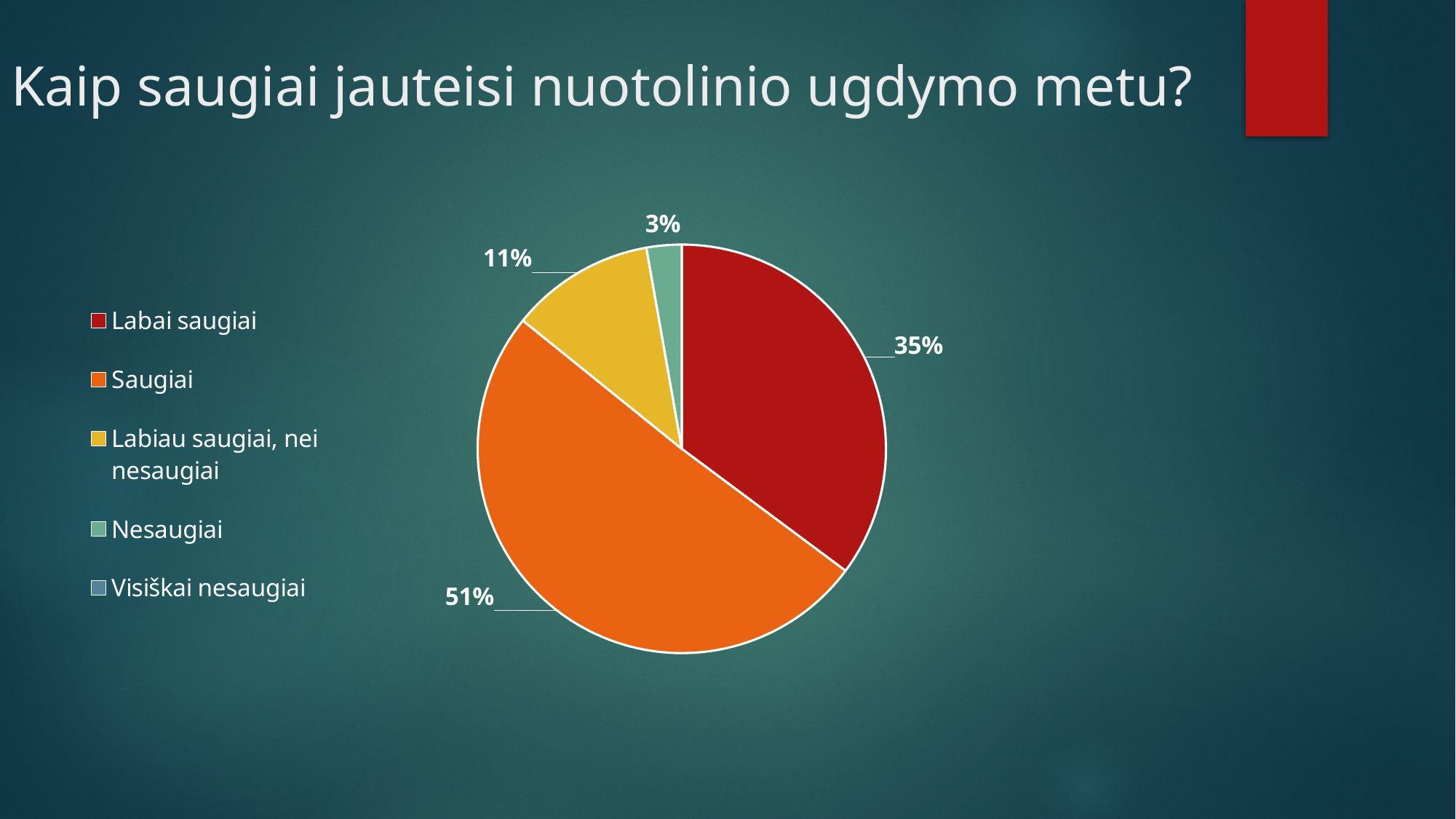
What type of chart is shown on the slide? pie chart What is the value shown for "Labai saugiai"? 35% What is the title of the slide containing the chart? Kaip saugiai jauteisi nuotolinio ugdymo metu? What is the value shown for "Nesaugiai"? 3% Which is larger, the share for "Labai saugiai" or for "Labiau saugiai, nei nesaugiai"? Labai saugiai Which labelled slice of the pie is the smallest? Nesaugiai What is the difference between the "Saugiai" and "Labai saugiai" shares? 16% How many entries does the legend list? 5 What is the value shown for "Labiau saugiai, nei nesaugiai"? 11% What share of the pie does "Saugiai" take? 51% Which category has the largest slice of the pie? Saugiai What colour is the slice for "Labiau saugiai, nei nesaugiai"? yellow